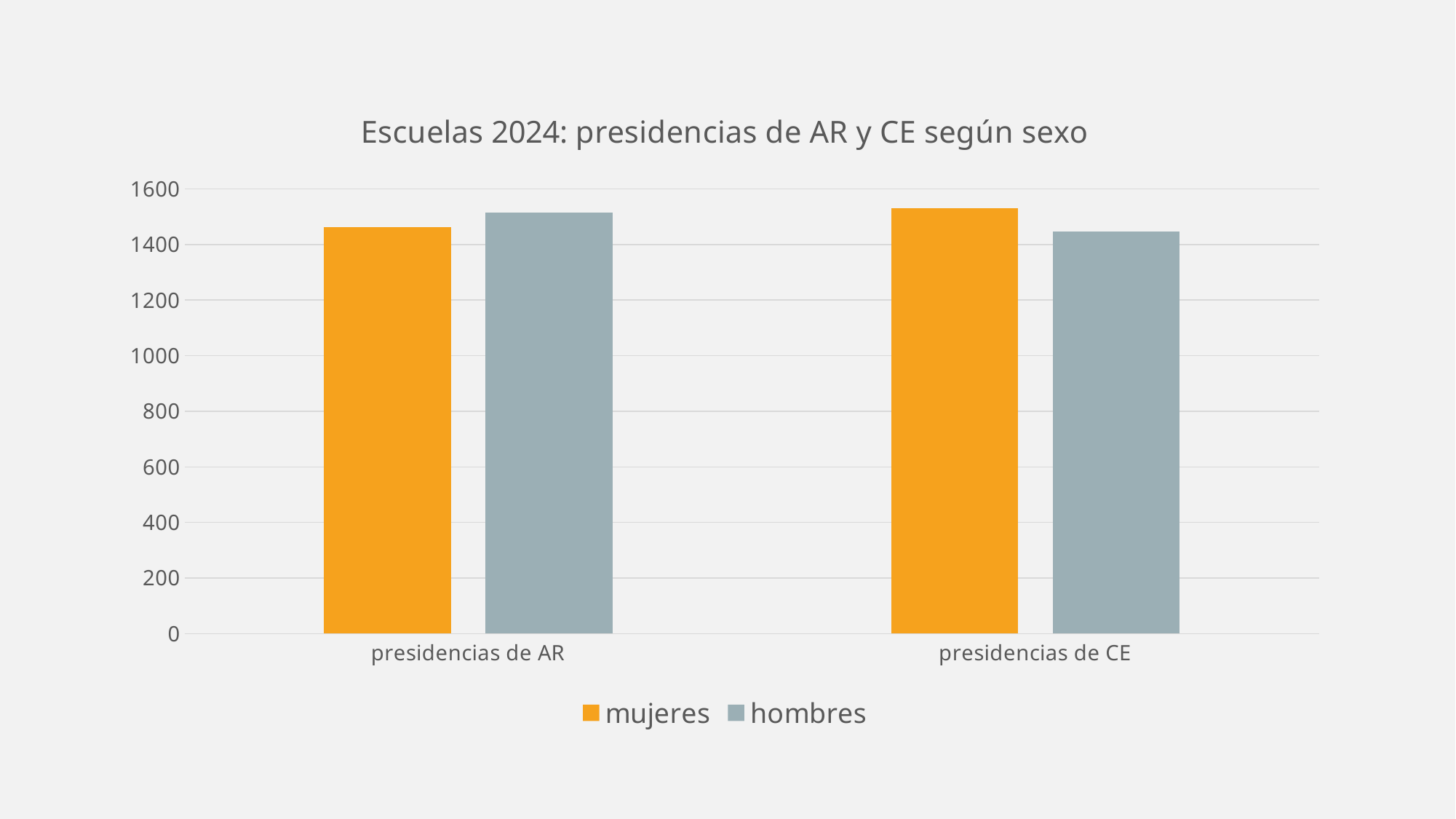
For presidencias de AR, which is larger: mujeres or hombres? hombres Is the value for hombres in presidencias de CE greater or less than 1500? less How many categories are shown on the x axis? 2 Which series is shown in orange? mujeres What kind of chart is shown on the slide? bar chart Is the value for mujeres in presidencias de AR greater or less than 1400? greater How many series does the legend list? 2 For presidencias de CE, which is larger: mujeres or hombres? mujeres Is the value for hombres in presidencias de AR greater or less than 1600? less What is the title of the chart? Escuelas 2024: presidencias de AR y CE según sexo